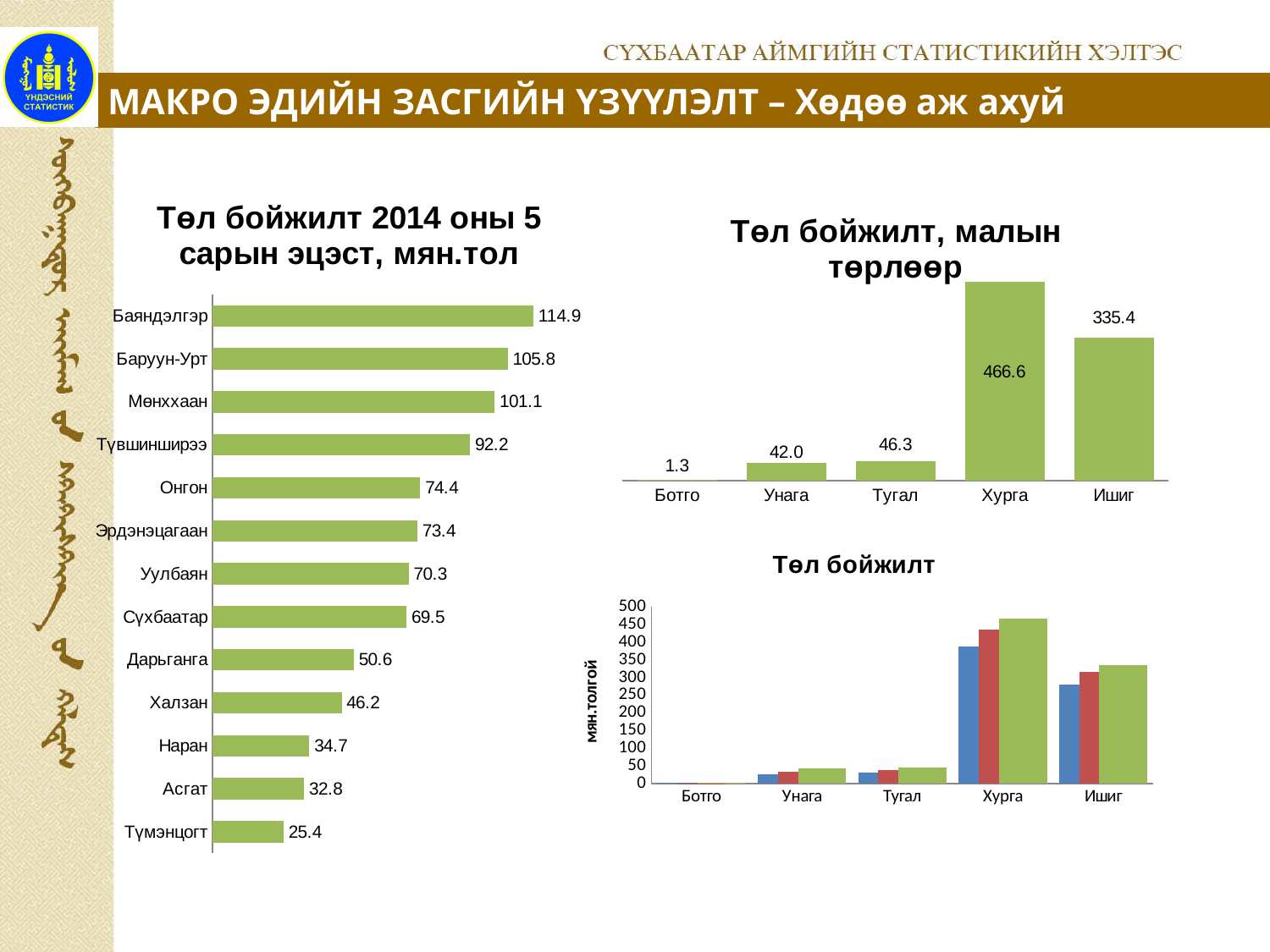
In the chart titled "Төл бойжилт, малын төрлөөр", what is the difference between Хурга and Ишиг? 131.2 In the chart titled "Төл бойжилт" at the bottom right, is the value of the blue bar for Хурга greater or less than 350? greater In the chart titled "Төл бойжилт 2014 оны 5 сарын эцэст, мян.тол", what is the value for Баяндэлгэр? 114.9 In the chart titled "Төл бойжилт, малын төрлөөр", what is the value for Ботго? 1.3 In the chart titled "Төл бойжилт" at the bottom right, how many bars are shown for each category? 3 In the chart titled "Төл бойжилт 2014 оны 5 сарын эцэст, мян.тол", which category has the lowest value? Түмэнцогт In the chart titled "Төл бойжилт 2014 оны 5 сарын эцэст, мян.тол", which is larger, Дарьганга or Халзан? Дарьганга In the chart titled "Төл бойжилт 2014 оны 5 сарын эцэст, мян.тол", how many categories are shown? 13 In the chart titled "Төл бойжилт, малын төрлөөр", what is the value for Хурга? 466.6 In the chart titled "Төл бойжилт 2014 оны 5 сарын эцэст, мян.тол", what is the value for Наран? 34.7 In the chart titled "Төл бойжилт, малын төрлөөр", which category has the highest value? Хурга In the chart titled "Төл бойжилт 2014 оны 5 сарын эцэст, мян.тол", what is the difference between Баруун-Урт and Мөнххаан? 4.7